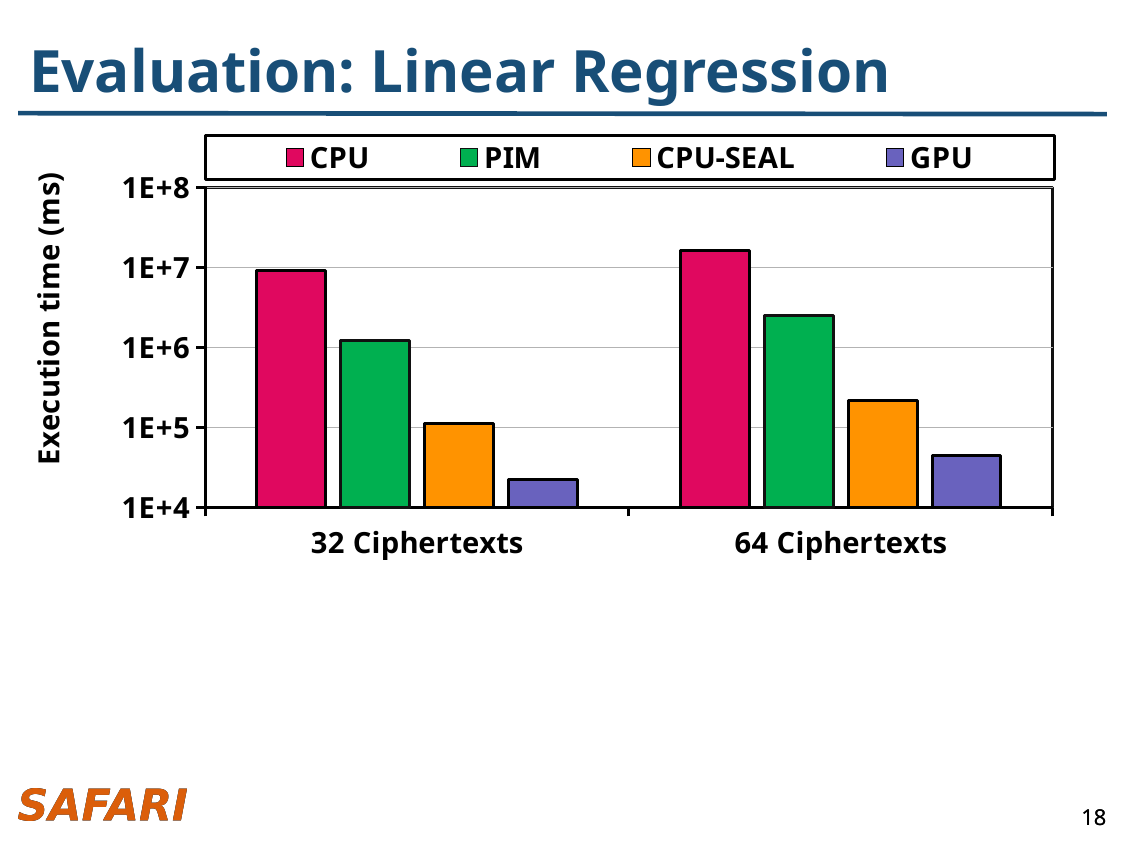
What kind of chart is shown on the slide? bar chart How many series does the legend list? 4 For 32 Ciphertexts, which has the larger execution time, PIM or CPU-SEAL? PIM Which bar is the tallest in the whole chart? CPU at 64 Ciphertexts Is the execution time for GPU at 32 Ciphertexts greater or less than 1E+5? less What is the label of the y axis? Execution time (ms) Is the execution time for PIM at 64 Ciphertexts greater or less than 1E+6? greater Is the execution time for CPU at 64 Ciphertexts greater or less than 1E+7? greater Does the execution time for GPU rise or fall from 32 Ciphertexts to 64 Ciphertexts? rise Which series has the highest execution time for 64 Ciphertexts? CPU Which series has the lowest execution time for 32 Ciphertexts? GPU How many categories are shown on the x axis? 2